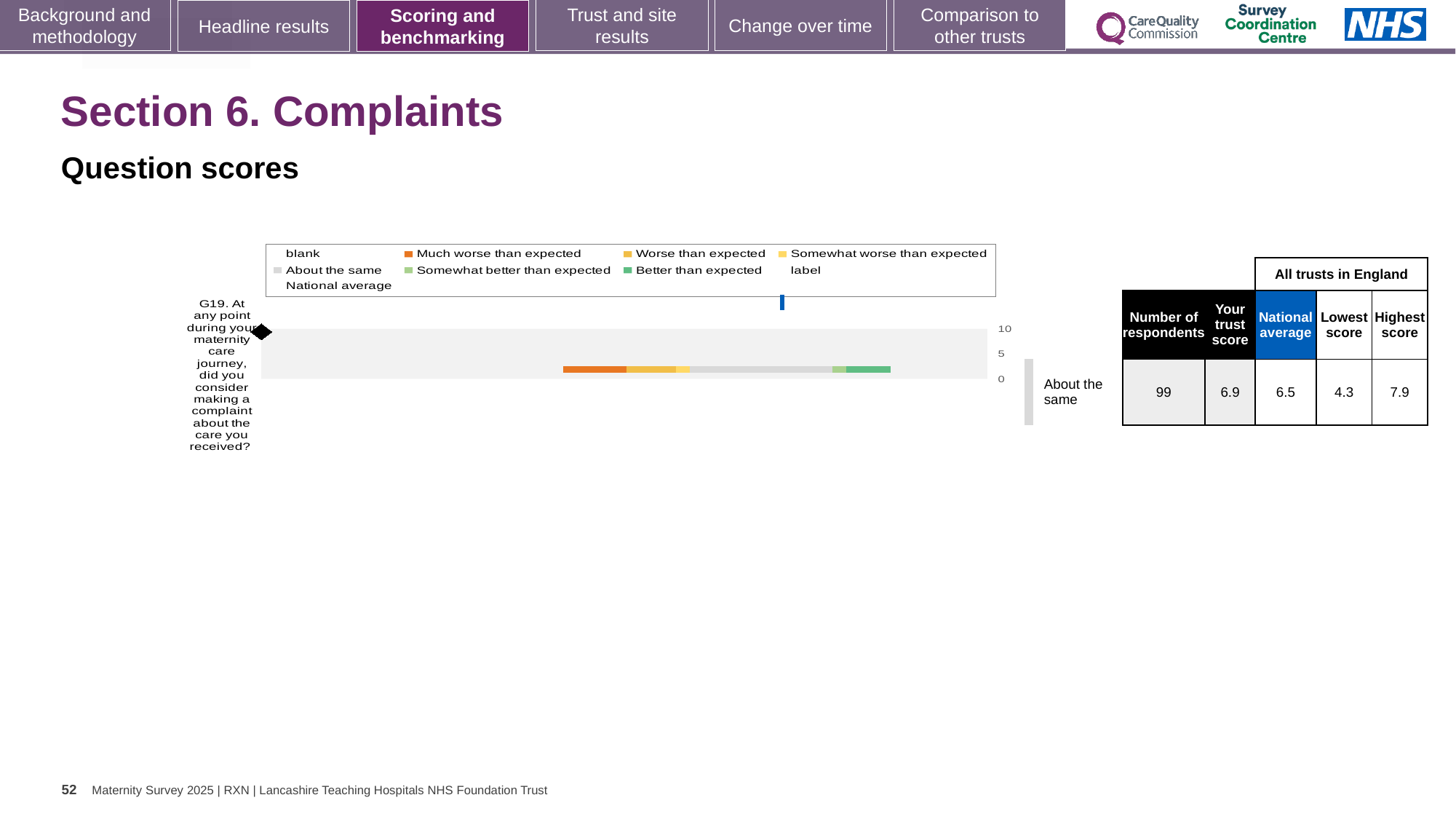
What is the trust score for question G19? 6.9 What is the national average for question G19? 6.5 What is the lowest score across all trusts in England for question G19? 4.3 How many respondents answered question G19? 99 What colour does the legend use for 'Much worse than expected'? Orange How many survey questions are plotted in the chart? 1 What kind of chart is shown on the slide? Bar chart What is the highest score across all trusts in England for question G19? 7.9 Is the trust score for question G19 greater or less than 5? greater What is the question code of the item plotted in the chart? G19 What is the difference between the highest score and the lowest score for question G19? 3.6 Which is larger for question G19, the trust score or the national average? Trust score